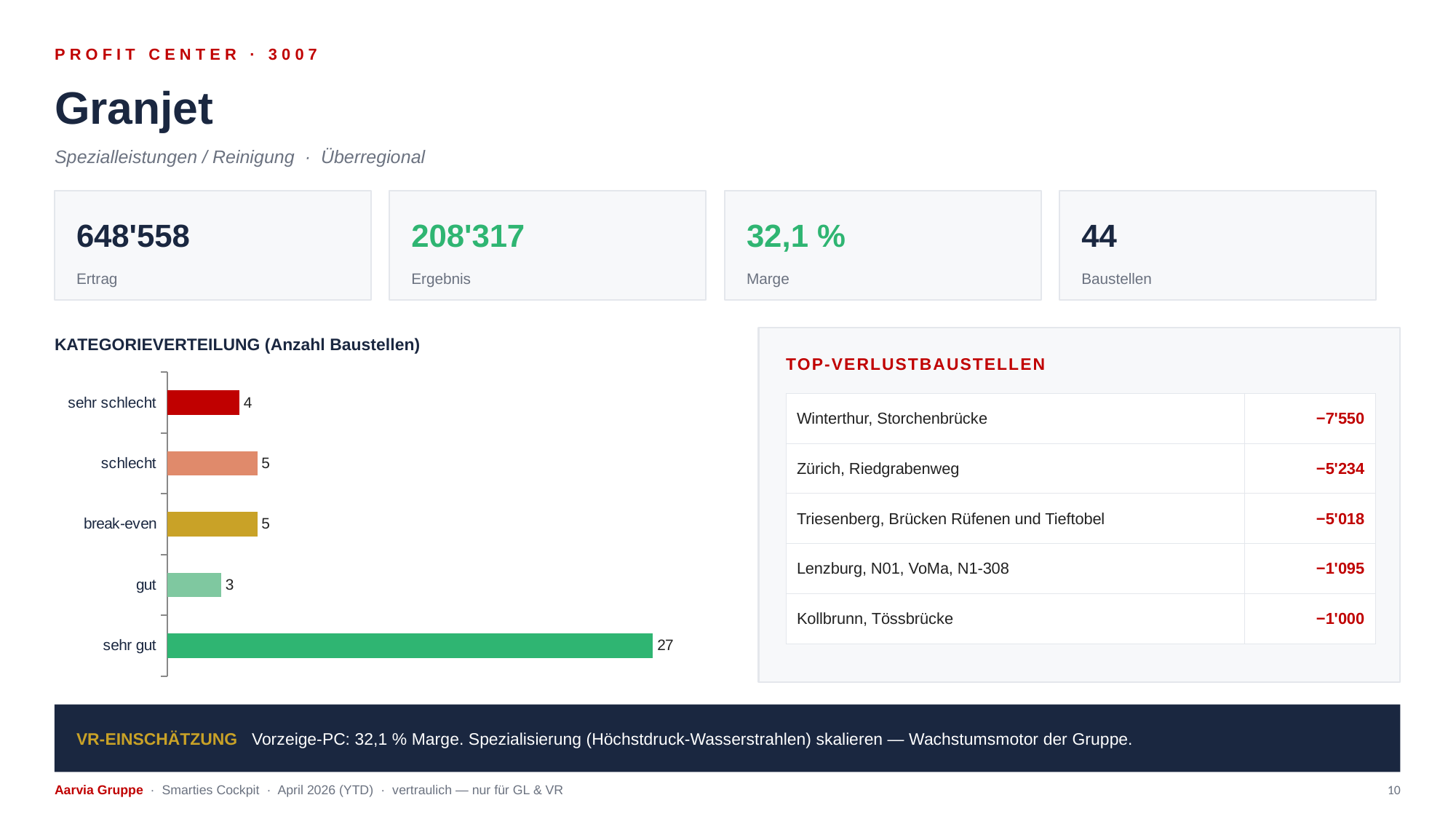
What is the total of all values shown in the Kategorieverteilung chart? 44 Which category has the lowest number of Baustellen in the Kategorieverteilung chart? gut What is the value for "sehr gut" in the Kategorieverteilung chart? 27 What kind of chart is the Kategorieverteilung chart? bar chart How many categories are shown in the Kategorieverteilung chart? 5 What is the difference between the values for "sehr gut" and "sehr schlecht" in the Kategorieverteilung chart? 23 What is the value for "sehr schlecht" in the Kategorieverteilung chart? 4 What is the value for "gut" in the Kategorieverteilung chart? 3 What is the title of the bar chart on the slide? KATEGORIEVERTEILUNG (Anzahl Baustellen) Which category has the highest number of Baustellen in the Kategorieverteilung chart? sehr gut In the Kategorieverteilung chart, which is larger: the value for "schlecht" or the value for "gut"? schlecht What colour is the bar for "sehr schlecht" in the Kategorieverteilung chart? red